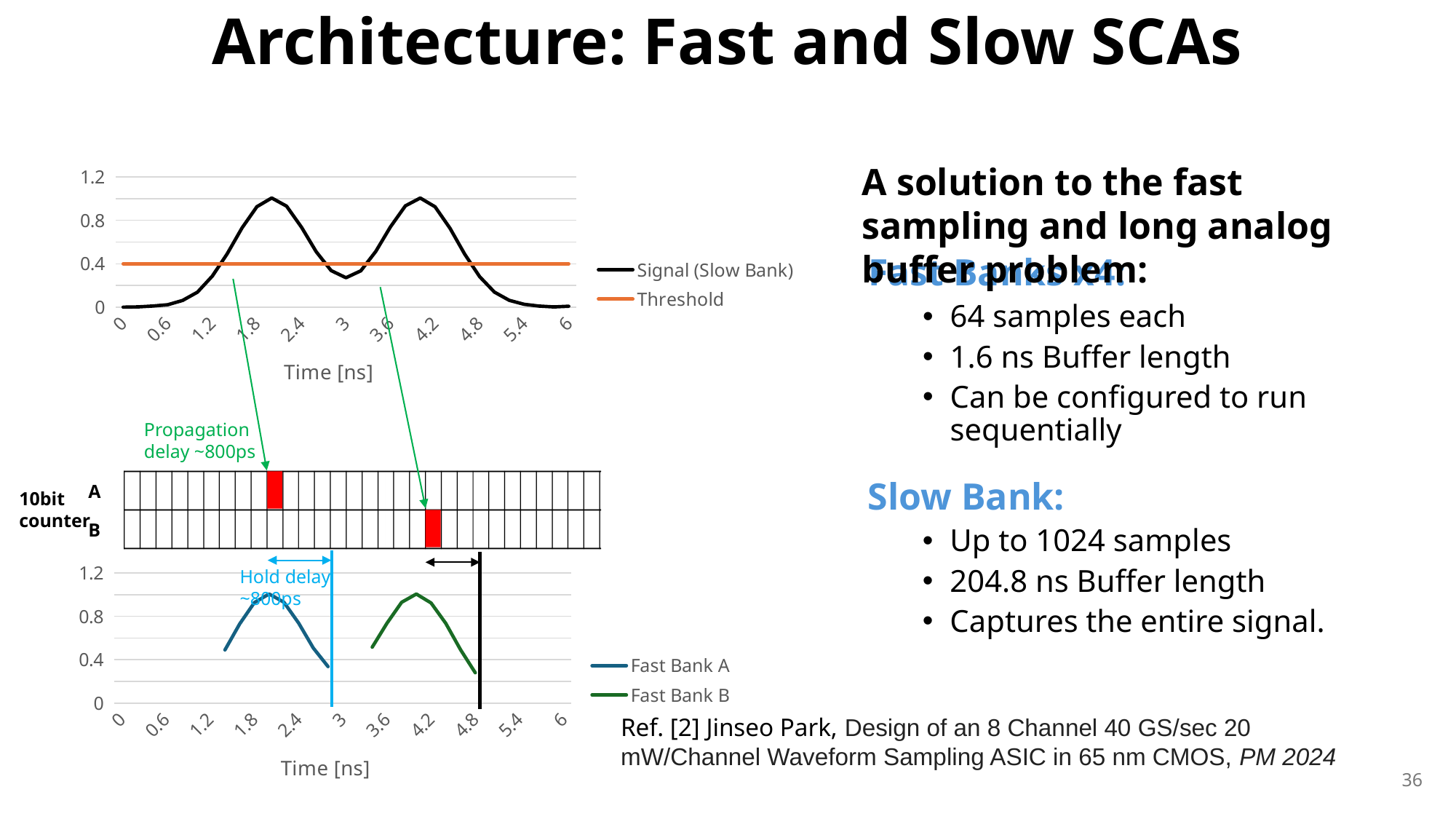
In the top chart, does Signal (Slow Bank) rise or fall between 1.2 ns and 1.8 ns? rise How many series does the legend of the top chart list? 2 In the top chart, is the peak value of Signal (Slow Bank) near 1.8 ns greater or less than 0.8? greater In the top chart, at what value does the Threshold line sit? 0.4 In the bottom chart, does Fast Bank A rise or fall between 2.4 ns and 3 ns? fall In the top chart, which is larger at 1.8 ns: Signal (Slow Bank) or Threshold? Signal (Slow Bank) In the top chart, what is the value of Signal (Slow Bank) at time 0? 0 How many series does the legend of the bottom chart list? 2 What is the x-axis title of the bottom chart? Time [ns] In the top chart, is the value of Signal (Slow Bank) at 3 ns greater or less than 0.4? less What kind of chart is the top chart with the Signal (Slow Bank) and Threshold series? line chart In the bottom chart, is the peak value of Fast Bank B greater or less than 0.8? greater